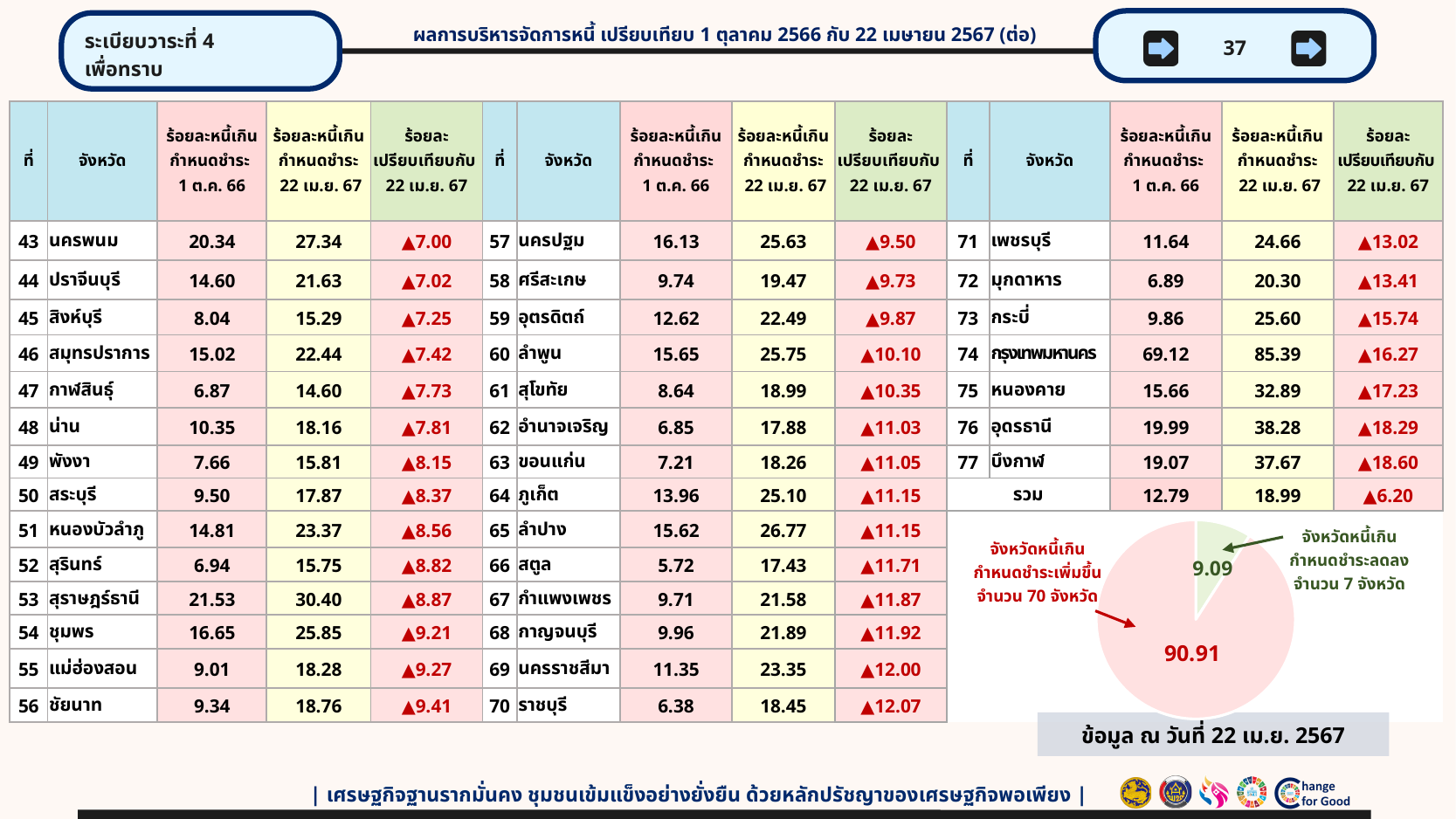
According to the pie chart labels, how many provinces are in the slice for increased overdue debt? 70 จังหวัด How many slices does the pie chart have? 2 Which slice of the pie chart is the smallest? จังหวัดหนี้เกินกำหนดชำระลดลง (9.09) In the pie chart, what value is shown for the slice labelled จังหวัดหนี้เกินกำหนดชำระลดลง? 9.09 In the pie chart, is the slice for provinces with increased overdue debt larger or smaller than the slice for provinces with decreased overdue debt? larger In the pie chart, what value is shown for the slice labelled จังหวัดหนี้เกินกำหนดชำระเพิ่มขึ้น? 90.91 Is the value of the green slice in the pie chart greater or less than 10? less What colour is the 9.09 slice in the pie chart? green Which slice of the pie chart is the largest? จังหวัดหนี้เกินกำหนดชำระเพิ่มขึ้น (90.91) In the pie chart, what is the difference between the 90.91 slice and the 9.09 slice? 81.82 What kind of chart is shown at the bottom right of the slide? pie chart What is the total of the two slice values shown in the pie chart? 100.00